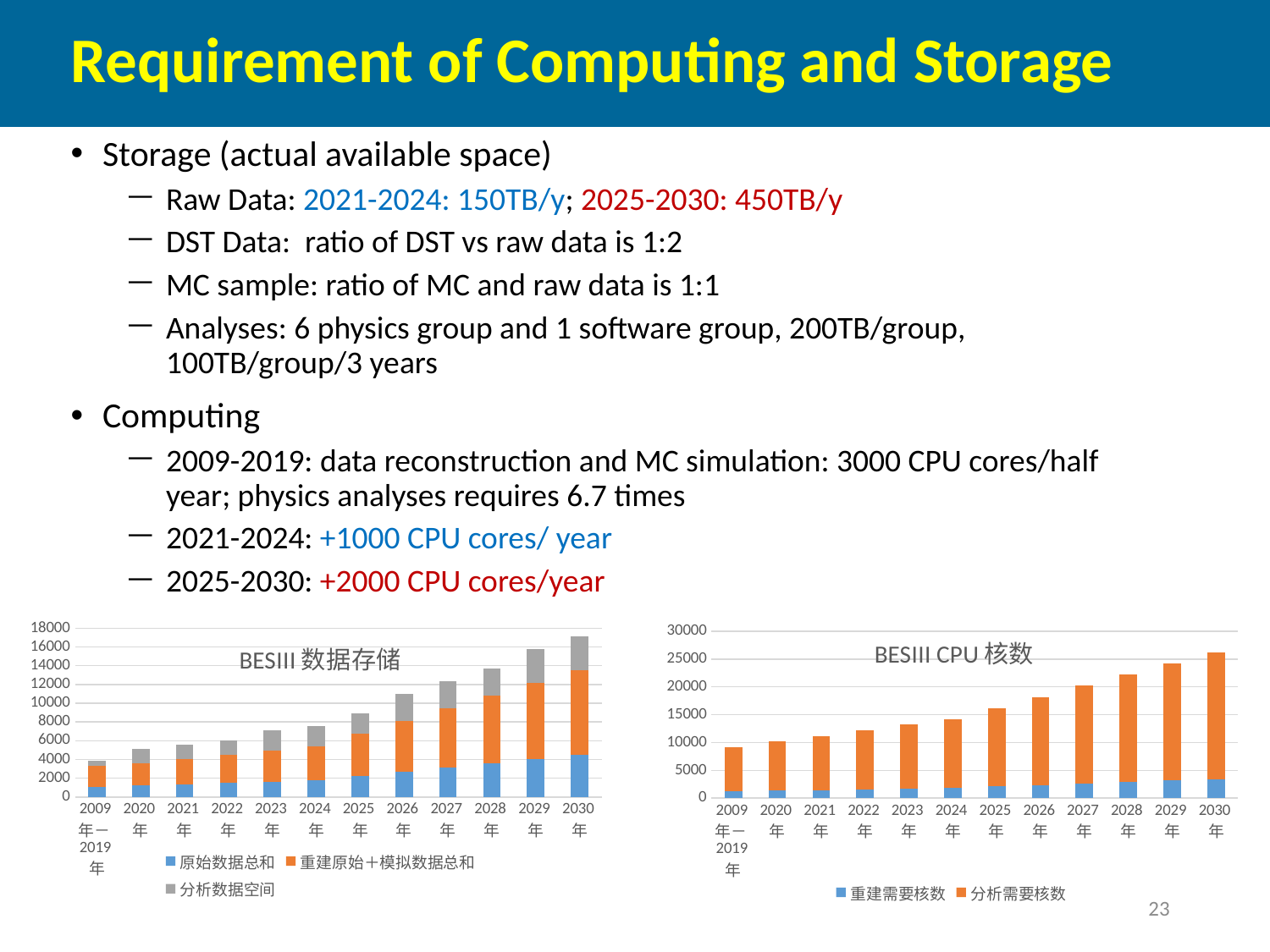
In the "BESIII CPU 核数" chart, which category has the shortest stacked bar? 2009年—2019年 What type of chart is the "BESIII 数据存储" chart on the left? stacked bar chart In the "BESIII 数据存储" chart, which series is shown in orange? 重建原始＋模拟数据总和 What type of chart is the "BESIII CPU 核数" chart on the right? stacked bar chart In the "BESIII 数据存储" chart, is the total for 2030年 greater or less than 16000? greater In the "BESIII CPU 核数" chart, is the total for 2009年—2019年 greater or less than 10000? less How many series does the legend of the "BESIII 数据存储" chart list? 3 How many series does the legend of the "BESIII CPU 核数" chart list? 2 In the "BESIII CPU 核数" chart, is the total for 2030年 greater or less than 20000? greater In the "BESIII CPU 核数" chart, do the stacked bar totals rise or fall from 2009年—2019年 to 2030年? rise How many categories are shown on the x axis of the "BESIII CPU 核数" chart? 12 In the "BESIII 数据存储" chart, which category has the tallest stacked bar? 2030年